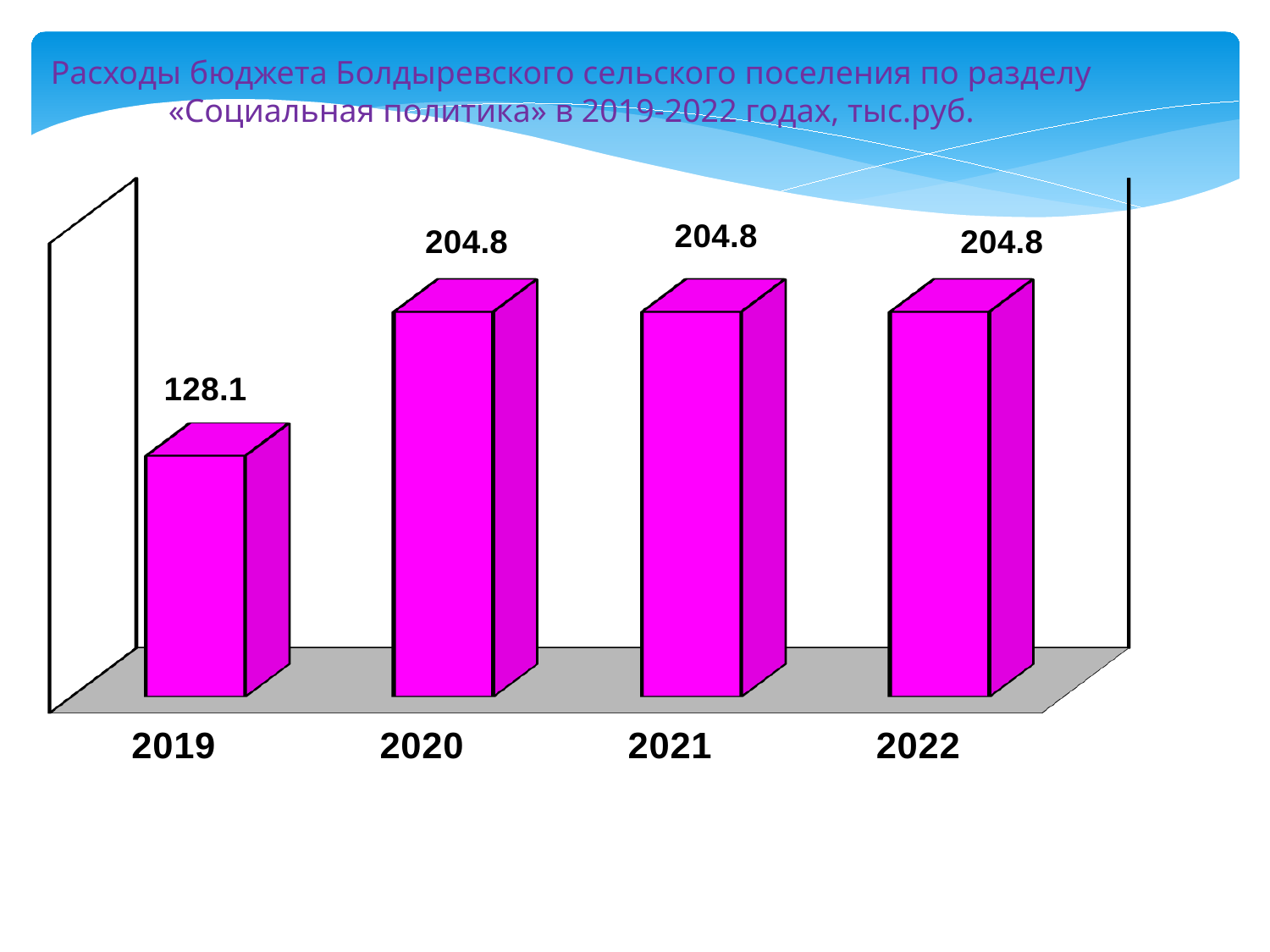
What kind of chart is shown on the slide? bar chart Does the value rise or fall from 2019 to 2020? rise What is the value for 2019? 128.1 Which year has the lowest value? 2019 Do the values change between 2020 and 2022? No, they stay at 204.8 What is the value for 2022? 204.8 What unit is stated in the chart title? тыс.руб. What is the difference between the values for 2020 and 2019? 76.7 What colour are the bars on the chart? magenta Which is larger, the value for 2019 or the value for 2021? 2021 How many years are shown on the chart? 4 What is the value for 2020? 204.8